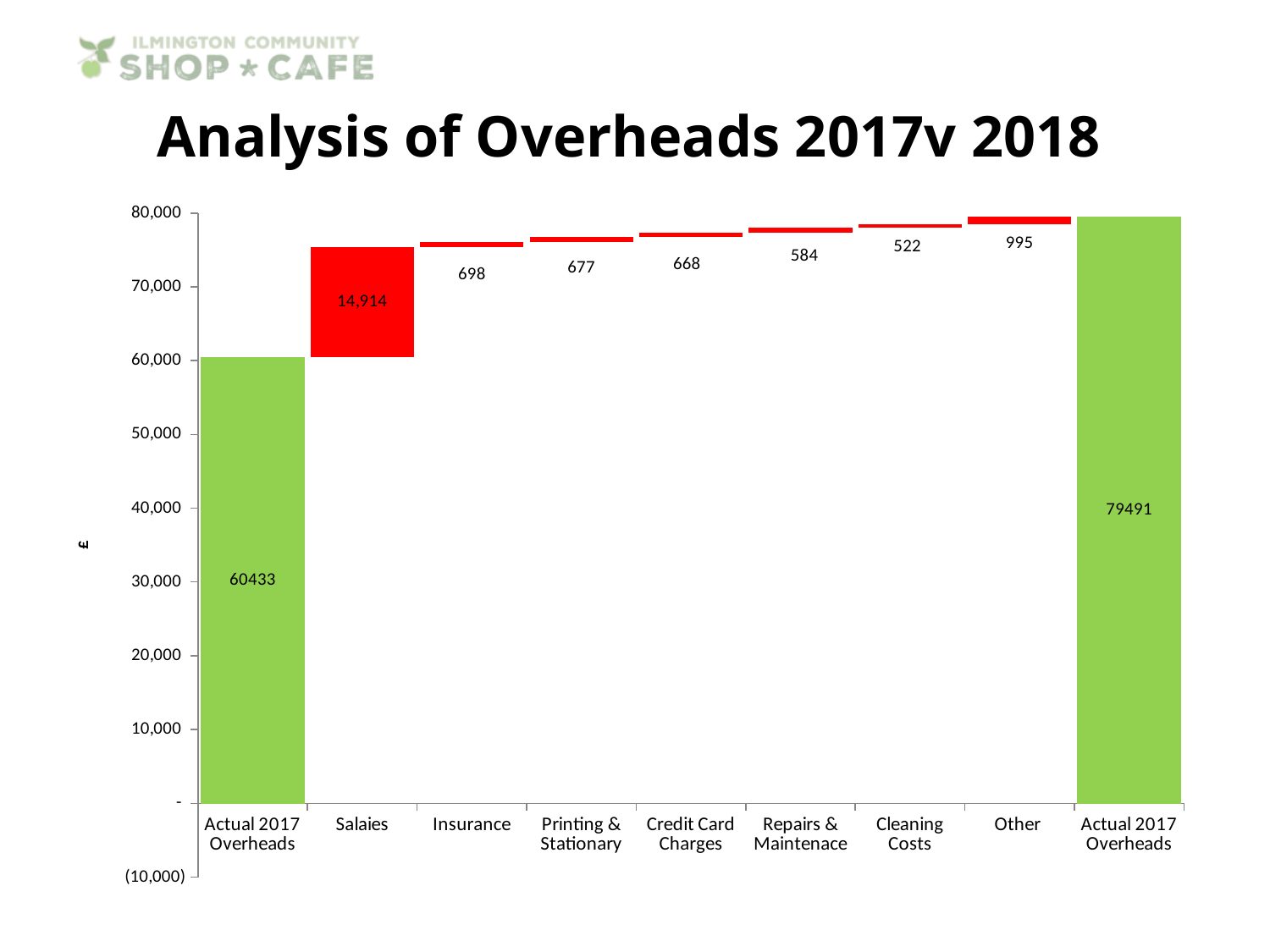
Which of the red increment categories has the smallest value? Cleaning Costs What is the value shown for Insurance? 698 Which is larger, the value for Printing & Stationary or the value for Credit Card Charges? Printing & Stationary What is the title of the chart? Analysis of Overheads 2017v 2018 What value is printed on the rightmost green bar? 79491 What is the value shown for Other? 995 How many categories are shown along the x axis? 9 Which of the red increment categories has the largest value? Salaies What value is printed on the leftmost green bar (Actual 2017 Overheads)? 60433 What kind of chart is shown on the slide? Bar chart What is the value shown for Salaies? 14,914 What is the difference between the Insurance value and the Cleaning Costs value? 176